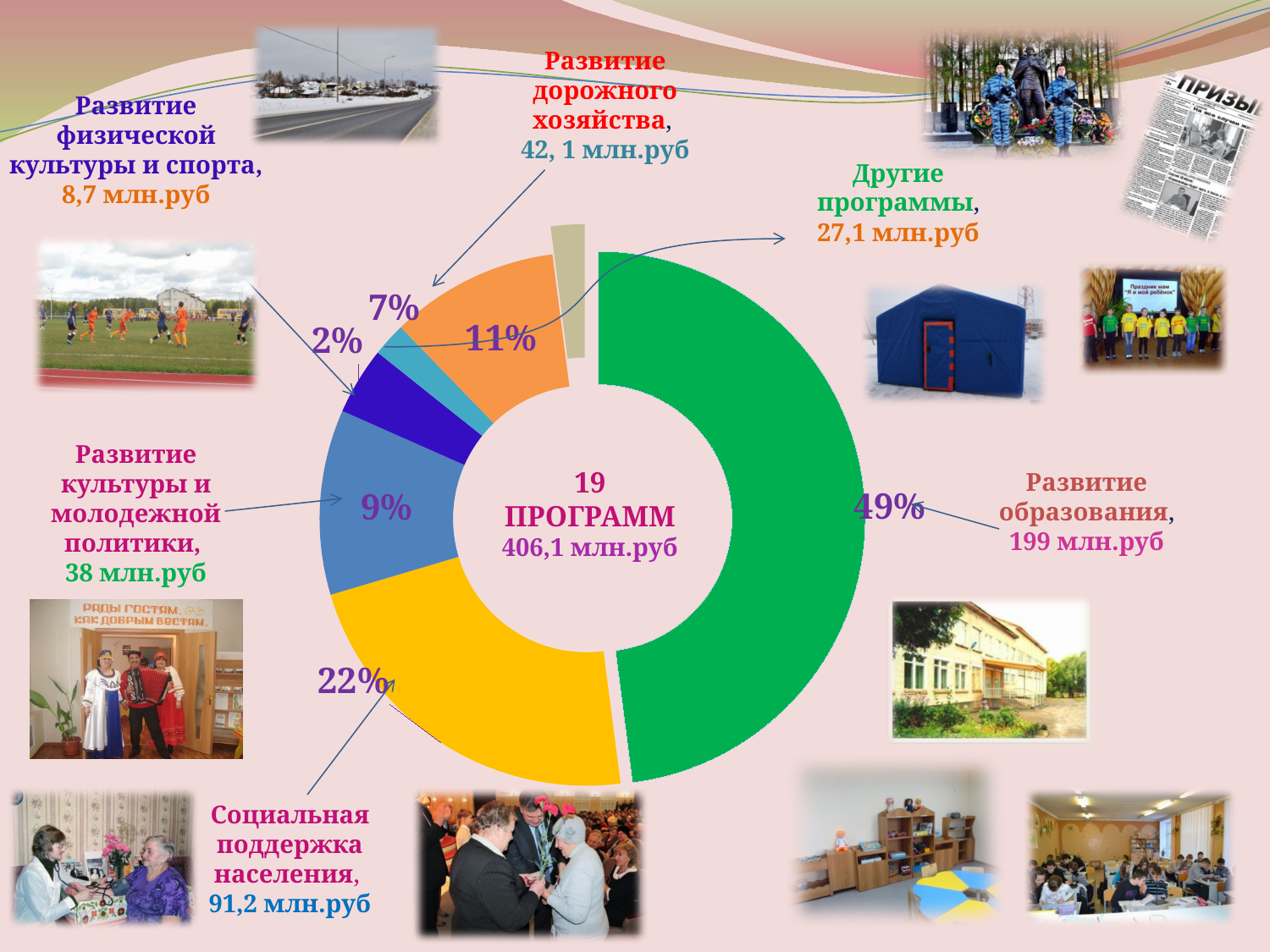
What kind of chart is shown on the slide? pie (doughnut) chart Which has the larger amount, Развитие образования or Социальная поддержка населения? Развитие образования What amount is given for Социальная поддержка населения? 91,2 млн.руб What amount is given for Развитие образования? 199 млн.руб What amount is given for Развитие физической культуры и спорта? 8,7 млн.руб How many programs are mentioned in the centre of the chart? 19 What share of the chart does Развитие образования take? 49% What is the smallest percentage shown on the chart? 2% What amount is given for Развитие культуры и молодежной политики? 38 млн.руб What amount is given for Другие программы? 27,1 млн.руб What total amount is printed in the centre of the chart? 406,1 млн.руб What is the largest percentage shown on the chart? 49%